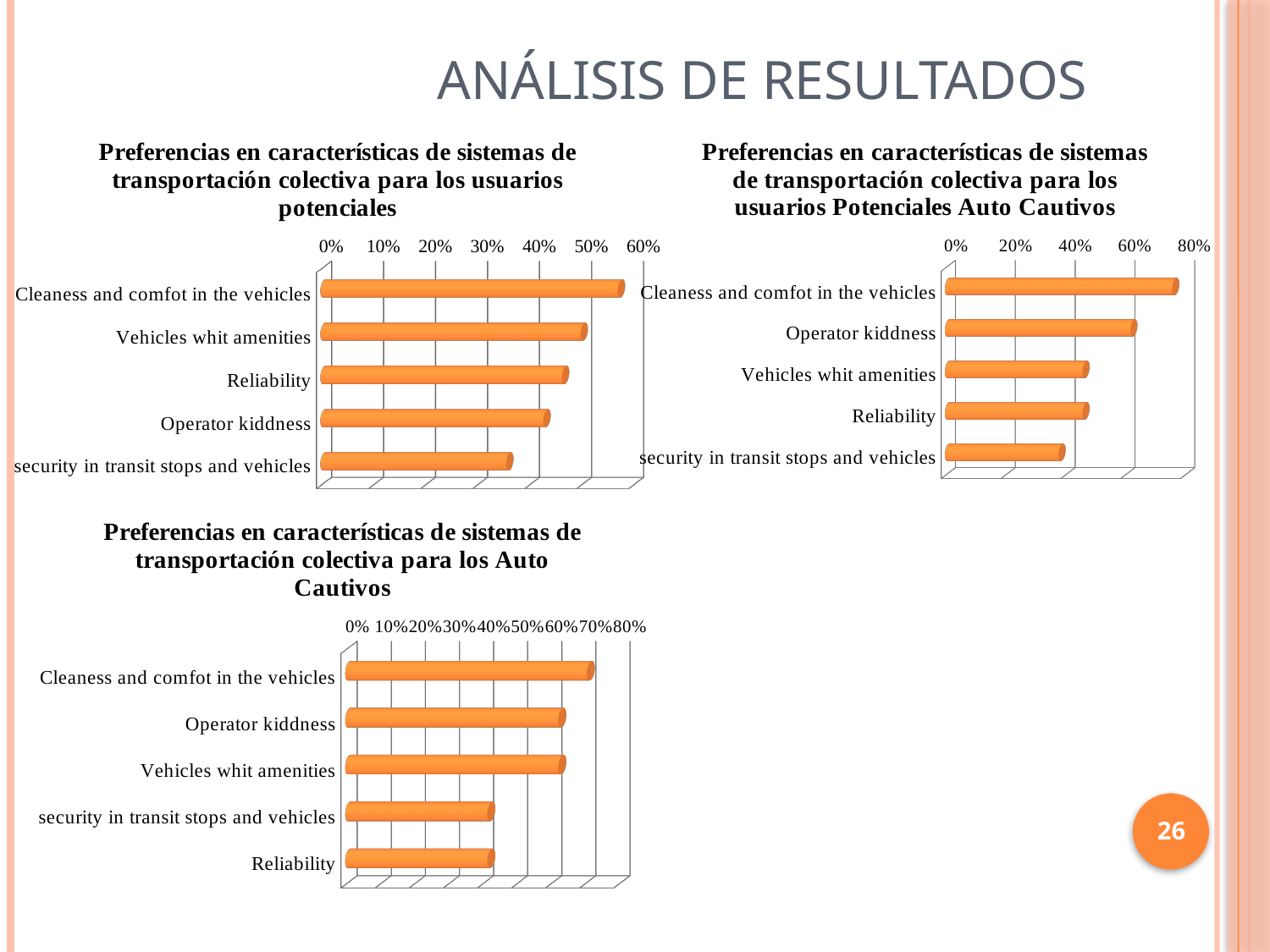
In the chart titled 'Preferencias en características de sistemas de transportación colectiva para los usuarios Potenciales Auto Cautivos', which is larger: 'Operator kiddness' or 'Reliability'? Operator kiddness In the chart titled 'Preferencias en características de sistemas de transportación colectiva para los usuarios potenciales', which category has the highest value? Cleaness and comfot in the vehicles In the chart titled 'Preferencias en características de sistemas de transportación colectiva para los usuarios potenciales', which category has the lowest value? security in transit stops and vehicles In the chart titled 'Preferencias en características de sistemas de transportación colectiva para los usuarios potenciales', which is larger: 'Vehicles whit amenities' or 'Operator kiddness'? Vehicles whit amenities In the chart titled 'Preferencias en características de sistemas de transportación colectiva para los usuarios Potenciales Auto Cautivos', is the value for 'Cleaness and comfot in the vehicles' greater or less than 60%? greater In the chart titled 'Preferencias en características de sistemas de transportación colectiva para los usuarios Potenciales Auto Cautivos', which category has the highest value? Cleaness and comfot in the vehicles In the chart titled 'Preferencias en características de sistemas de transportación colectiva para los usuarios potenciales', is the value for 'security in transit stops and vehicles' greater or less than 40%? less How many categories are shown in the chart titled 'Preferencias en características de sistemas de transportación colectiva para los usuarios potenciales'? 5 In the chart titled 'Preferencias en características de sistemas de transportación colectiva para los Auto Cautivos', which category has the highest value? Cleaness and comfot in the vehicles In the chart titled 'Preferencias en características de sistemas de transportación colectiva para los usuarios potenciales', is the value for 'Cleaness and comfot in the vehicles' greater or less than 50%? greater What type of chart is the chart titled 'Preferencias en características de sistemas de transportación colectiva para los Auto Cautivos'? bar chart In the chart titled 'Preferencias en características de sistemas de transportación colectiva para los usuarios Potenciales Auto Cautivos', which category has the lowest value? security in transit stops and vehicles